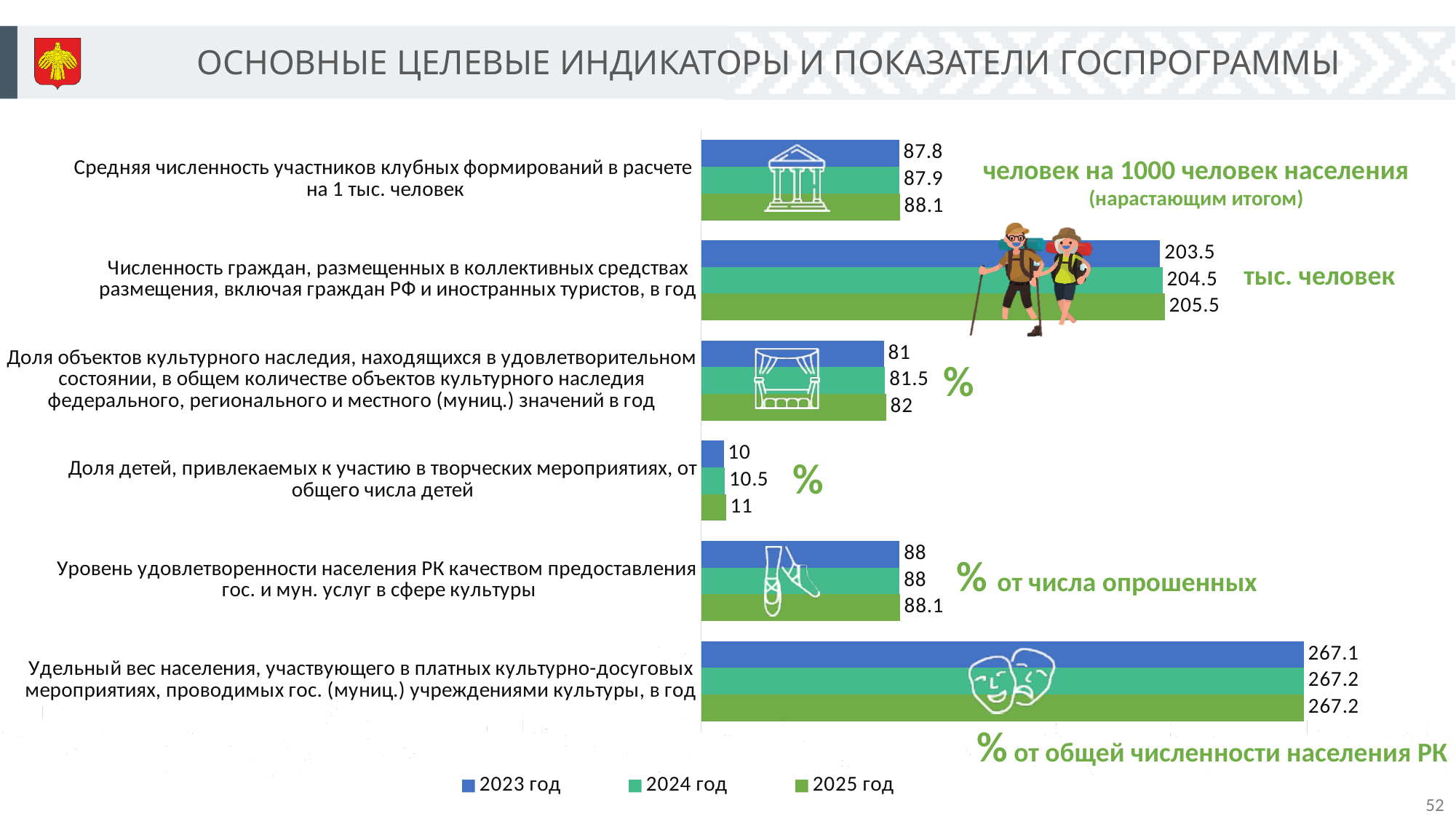
Do the values for "Доля объектов культурного наследия, находящихся в удовлетворительном состоянии..." rise or fall from 2023 год to 2025 год? rise What is the 2023 год value for "Численность граждан, размещенных в коллективных средствах размещения, включая граждан РФ и иностранных туристов, в год"? 203.5 How many categories (indicators) are plotted in the chart? 6 Which indicator has the highest 2025 год value? Удельный вес населения, участвующего в платных культурно-досуговых мероприятиях, проводимых гос. (муниц.) учреждениями культуры, в год What is the 2025 год value for "Доля детей, привлекаемых к участию в творческих мероприятиях, от общего числа детей"? 11 What type of chart is shown on the slide? bar chart How many series does the legend list? 3 What is the difference between the 2025 год and 2023 год values for "Численность граждан, размещенных в коллективных средствах размещения, включая граждан РФ и иностранных туристов, в год"? 2 Which legend entry is shown in blue? 2023 год Which indicator has the lowest 2023 год value? Доля детей, привлекаемых к участию в творческих мероприятиях, от общего числа детей What is the 2025 год value for "Удельный вес населения, участвующего в платных культурно-досуговых мероприятиях, проводимых гос. (муниц.) учреждениями культуры, в год"? 267.2 What is the 2024 год value for "Средняя численность участников клубных формирований в расчете на 1 тыс. человек"? 87.9